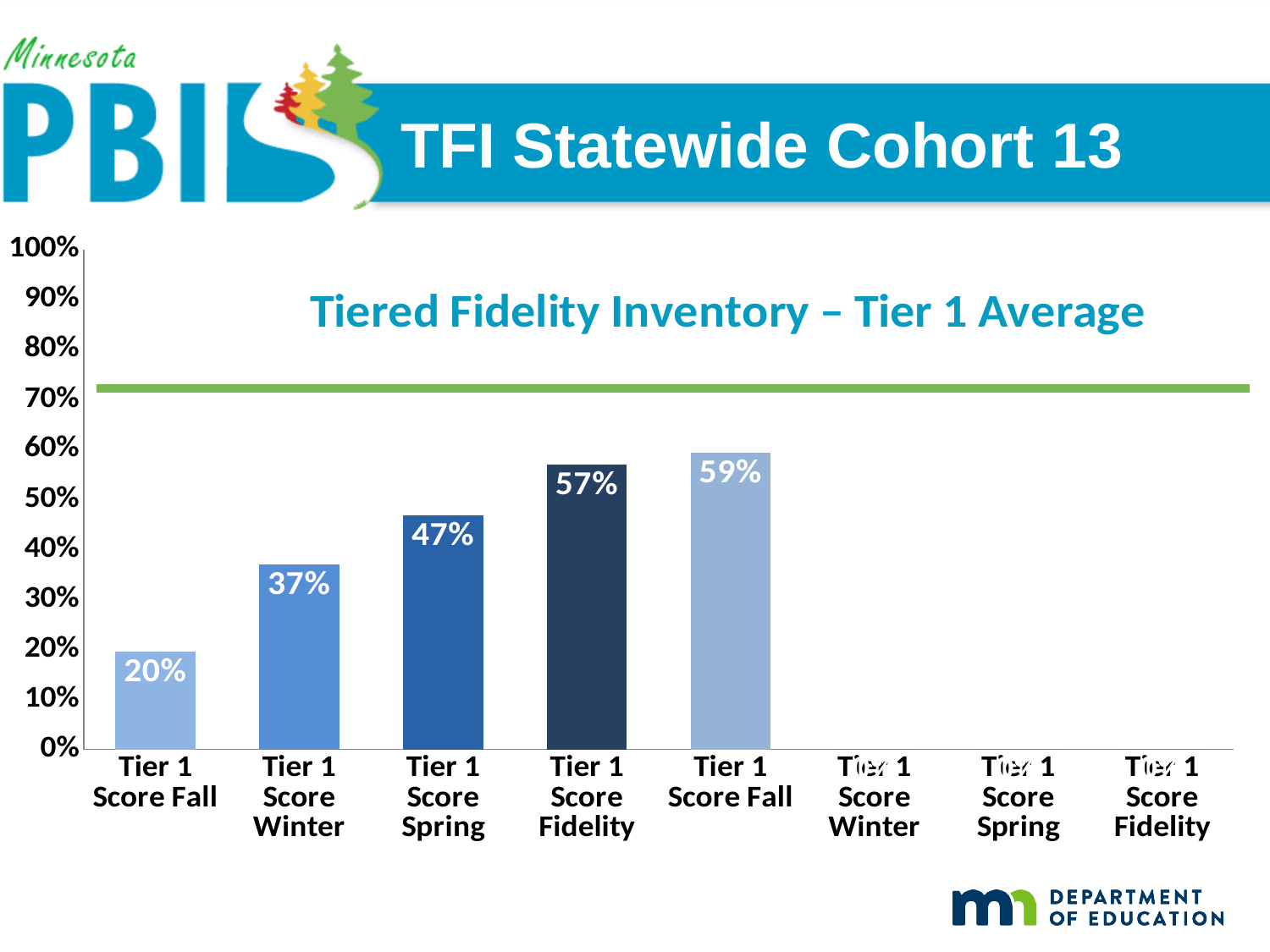
What is the value of the second 'Tier 1 Score Fall' bar (the fifth bar from the left)? 59% What is the value of the 'Tier 1 Score Spring' bar? 47% Which bar has the lowest value? Tier 1 Score Fall (the leftmost bar), 20% Which is larger, the 'Tier 1 Score Fidelity' bar or the 'Tier 1 Score Spring' bar? Tier 1 Score Fidelity What is the value of the 'Tier 1 Score Winter' bar? 37% Is the value of the 'Tier 1 Score Winter' bar greater or less than 40%? less What is the difference between the 'Tier 1 Score Spring' bar and the 'Tier 1 Score Winter' bar? 10% What is the value of the 'Tier 1 Score Fidelity' bar? 57% What is the title of the chart? Tiered Fidelity Inventory – Tier 1 Average What is the value of the first 'Tier 1 Score Fall' bar (the leftmost bar)? 20% What kind of chart is shown on the slide? Bar chart How many bars are plotted on the chart? 5